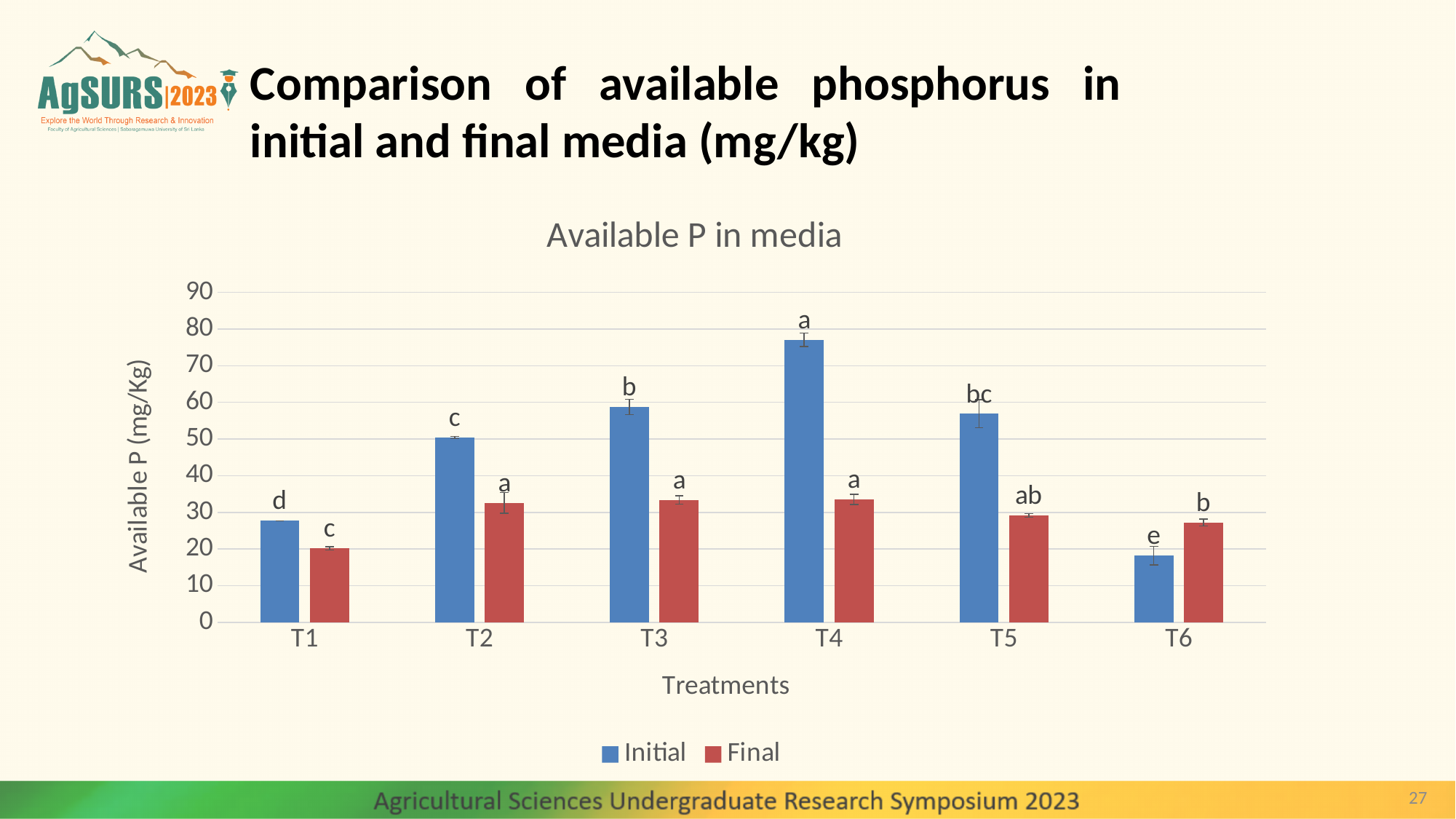
For T1, which is larger, the Initial value or the Final value? Initial Which treatment has the lowest Final value? T1 Is the Initial value for T6 greater or less than 20? less How many series does the chart's legend list? 2 For T6, which is larger, the Initial value or the Final value? Final Is the Final value for T6 greater or less than 20? greater How many treatments are shown on the x axis of the chart? 6 Is the Initial value for T4 greater or less than 70? greater Which treatment has the lowest Initial value? T6 What is the title of the chart? Available P in media Which treatment has the highest Initial value? T4 What kind of chart is shown on the slide? bar chart